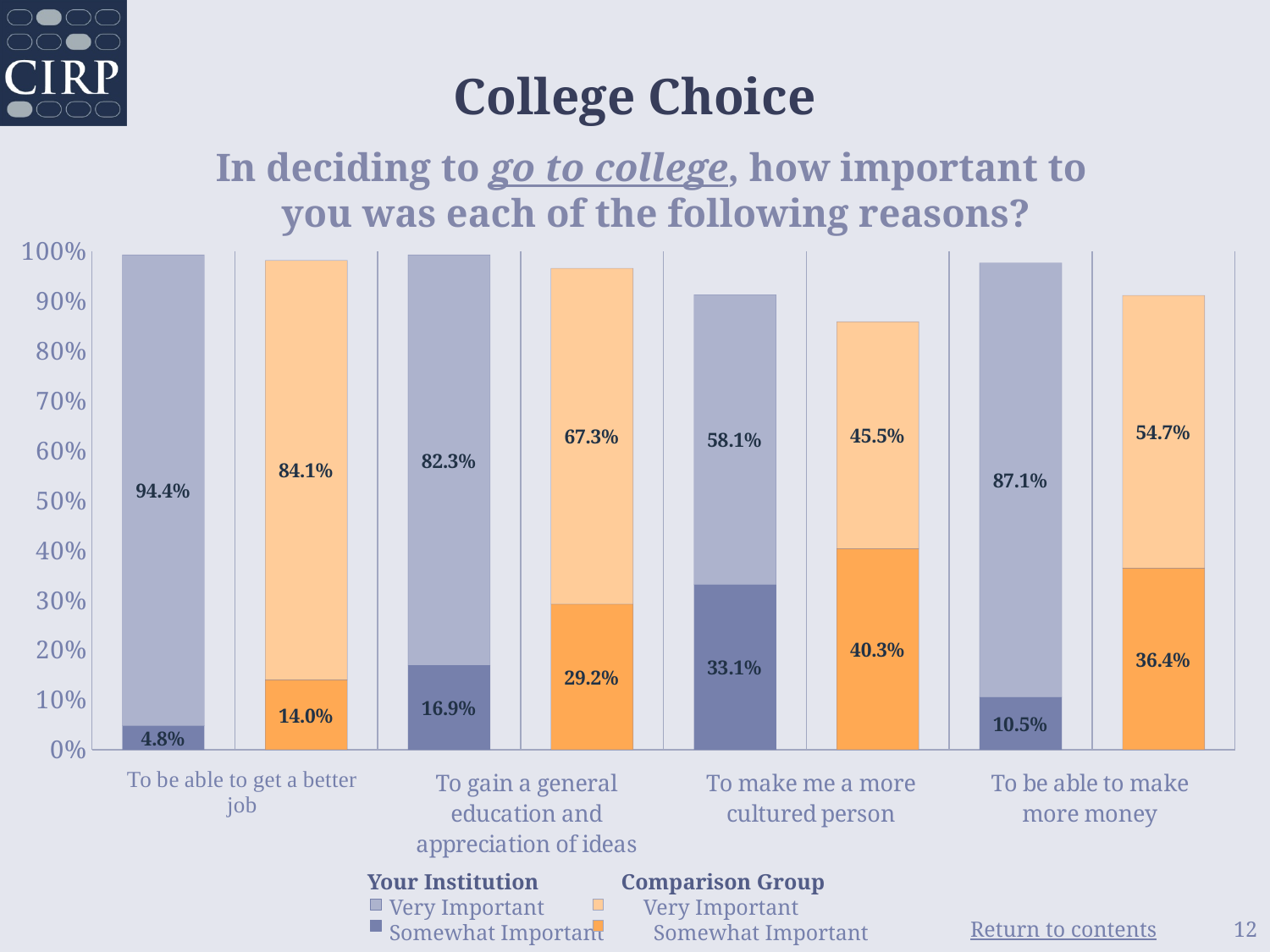
Which reason has the lowest Very Important percentage for the Comparison Group? To make me a more cultured person What is the combined Very Important and Somewhat Important total for the Comparison Group on "To be able to get a better job"? 98.1% What type of chart is shown on the slide? Stacked bar chart Which reason has the highest Very Important percentage for Your Institution? To be able to get a better job What is the difference between Your Institution's and the Comparison Group's Very Important percentages for "To be able to make more money"? 32.4% What percentage of the Comparison Group rated "To be able to make more money" as Somewhat Important? 36.4% How many reasons (categories) are shown on the x axis? 4 What percentage of Your Institution students rated "To be able to get a better job" as Very Important? 94.4% How many entries does the legend list? 4 What is the Comparison Group's Very Important percentage for "To gain a general education and appreciation of ideas"? 67.3% What is the combined Very Important and Somewhat Important total for Your Institution on "To make me a more cultured person"? 91.2% For "To make me a more cultured person", which group has the larger Somewhat Important percentage, Your Institution or the Comparison Group? Comparison Group